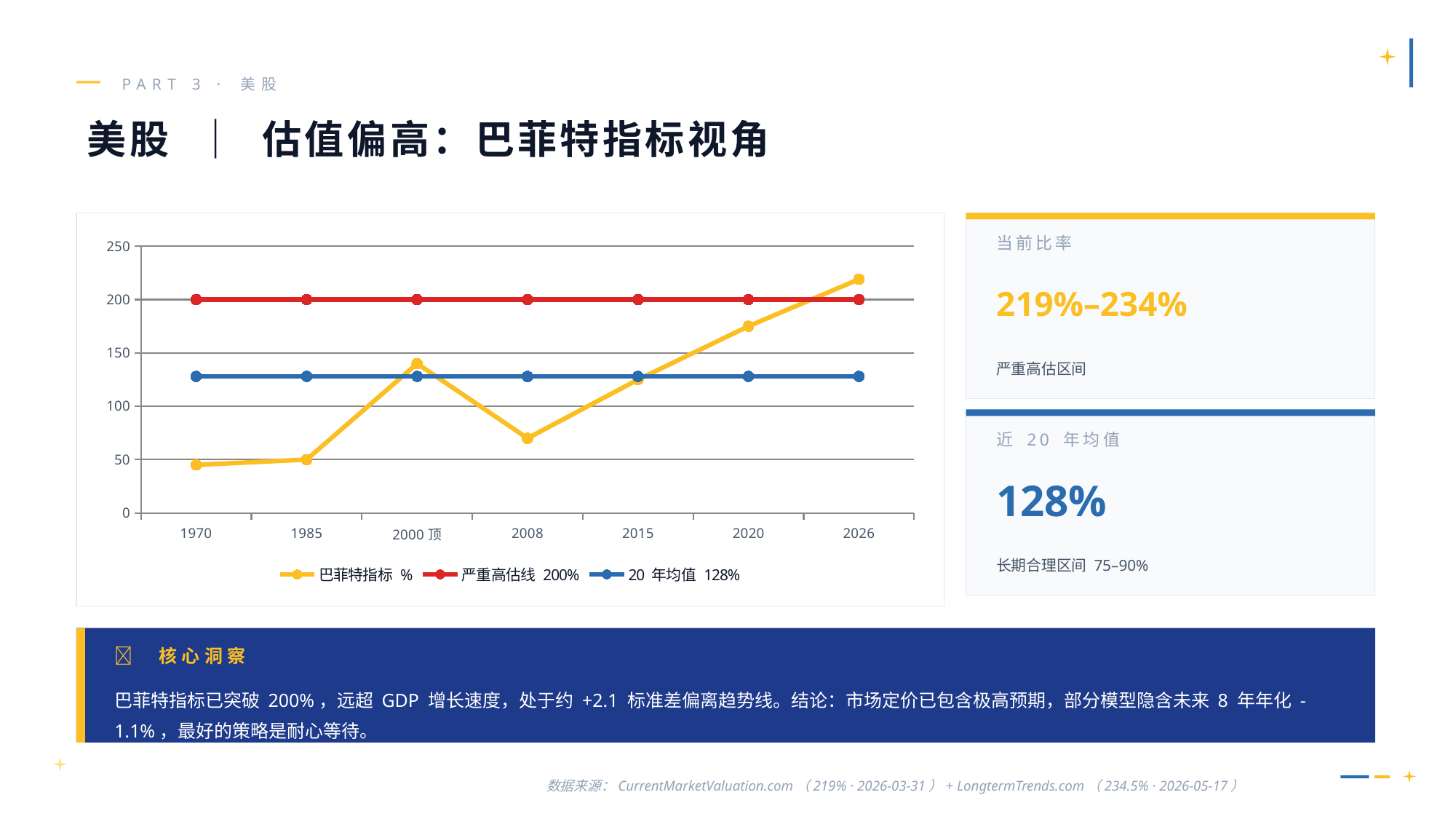
Does the 巴菲特指标 % series rise or fall from 2008 to 2026? rise What kind of chart is shown on the slide? line chart At which x-axis point is the 巴菲特指标 % series highest? 2026 What value does the 严重高估线 series hold across the chart? 200% How many points are plotted along the x axis of the chart? 7 Is the 巴菲特指标 % value at 2008 greater or less than 100? less How many series does the chart legend list? 3 Is the 巴菲特指标 % value at 2026 greater or less than 200? greater What is the difference between the 严重高估线 level and the 20 年均值 level? 72 Which is larger for the 巴菲特指标 % series: the value at 2000 顶 or the value at 2008? 2000 顶 Is the 巴菲特指标 % value at 2020 greater or less than 150? greater What value does the 20 年均值 series hold across the chart? 128%